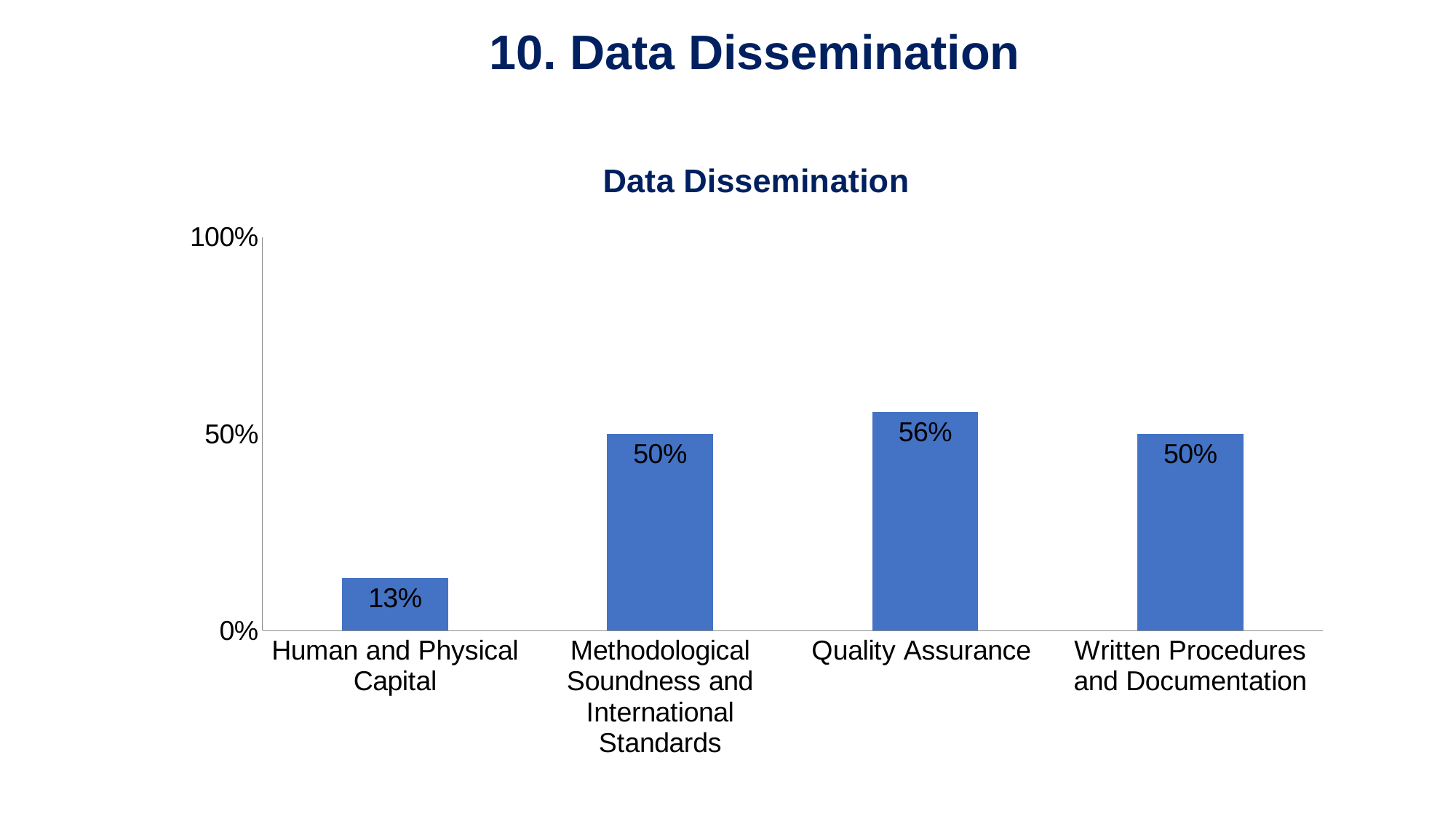
Which is larger, the value for Quality Assurance or the value for Written Procedures and Documentation? Quality Assurance What is the value for Quality Assurance? 56% What is the value for Written Procedures and Documentation? 50% Is the value for Human and Physical Capital greater or less than 50%? less What is the value for Methodological Soundness and International Standards? 50% What kind of chart is shown on the slide? bar chart Which category has the lowest value? Human and Physical Capital What is the value for Human and Physical Capital? 13% Which category has the highest value? Quality Assurance How many categories are shown in the chart? 4 What is the title of the chart? Data Dissemination What is the difference between the values for Quality Assurance and Human and Physical Capital? 43%